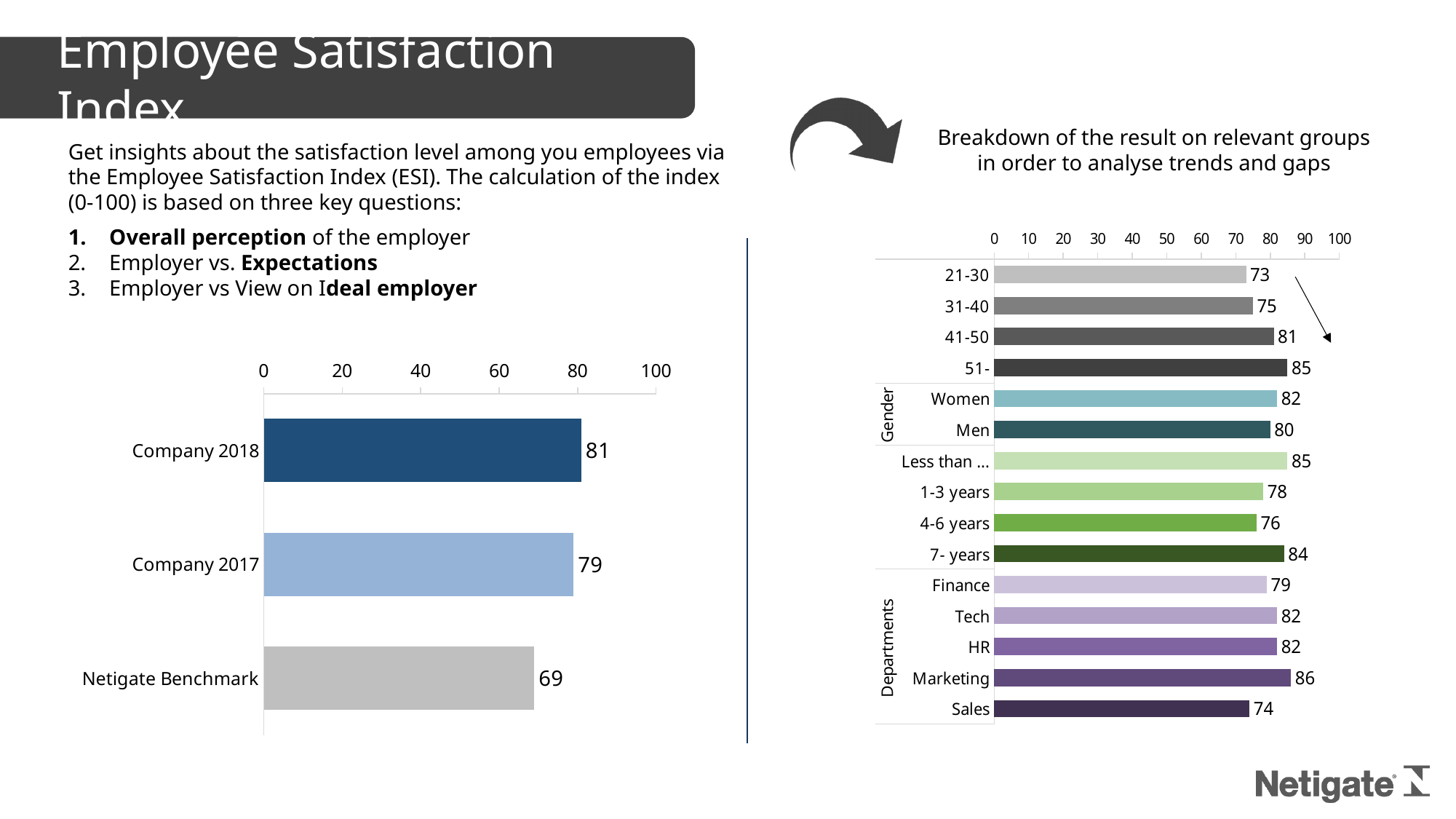
In the chart on the left, which category has the lowest value? Netigate Benchmark In the chart on the right, what is the value for Men? 80 In the chart on the right, what is the value for Marketing? 86 In the chart on the left, what is the value for Netigate Benchmark? 69 In the chart on the right, which category has the highest value? Marketing In the chart on the right, which is larger, the value for Sales or the value for Finance? Finance In the chart on the left, what is the value for Company 2018? 81 What kind of chart is the chart on the left? Bar chart In the chart on the left, how many bars are shown? 3 In the chart on the right, how many categories are plotted? 15 In the chart on the right, which category has the lowest value? 21-30 In the chart on the left, what is the difference between Company 2018 and Company 2017? 2